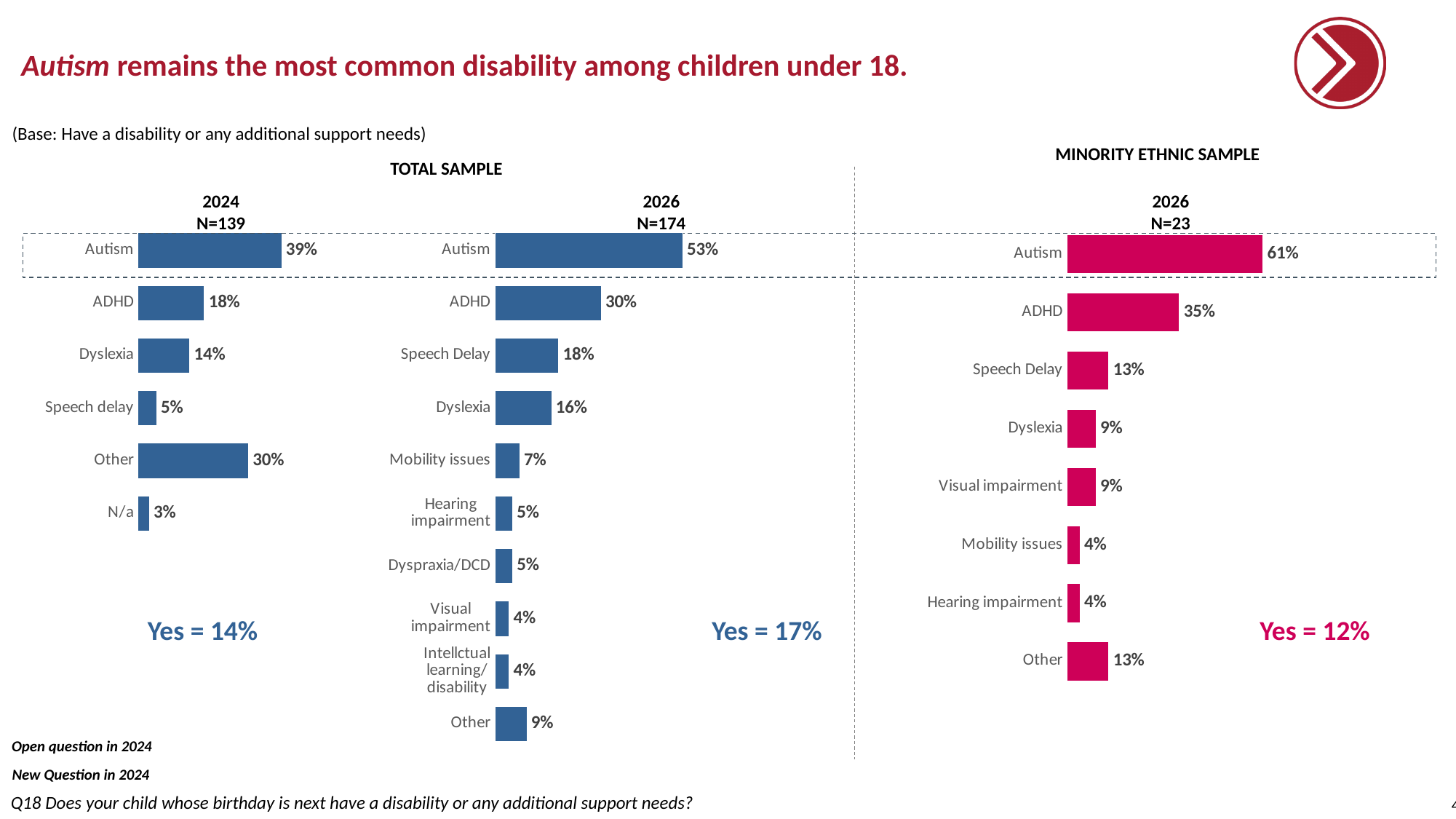
In the Total Sample 2026 chart, what is the value for ADHD? 30% In the Minority Ethnic Sample 2026 chart, what is the value for Speech Delay? 13% In the Total Sample 2024 chart, what is the value for Autism? 39% In the Minority Ethnic Sample 2026 chart, which category has the highest value? Autism In the Total Sample 2024 chart, which category has the lowest value? N/a In the Total Sample 2026 chart, what is the difference between the values for Autism and ADHD? 23% How many categories are shown in the Minority Ethnic Sample 2026 chart? 8 How many categories are shown in the Total Sample 2026 chart? 10 In the Total Sample 2024 chart, which is larger, the value for Dyslexia or the value for Other? Other What is the sample size (N) shown for the Minority Ethnic Sample 2026 chart? N=23 In the Total Sample 2026 chart, what is the value for Other? 9% What kind of chart is the Minority Ethnic Sample 2026 chart? Bar chart